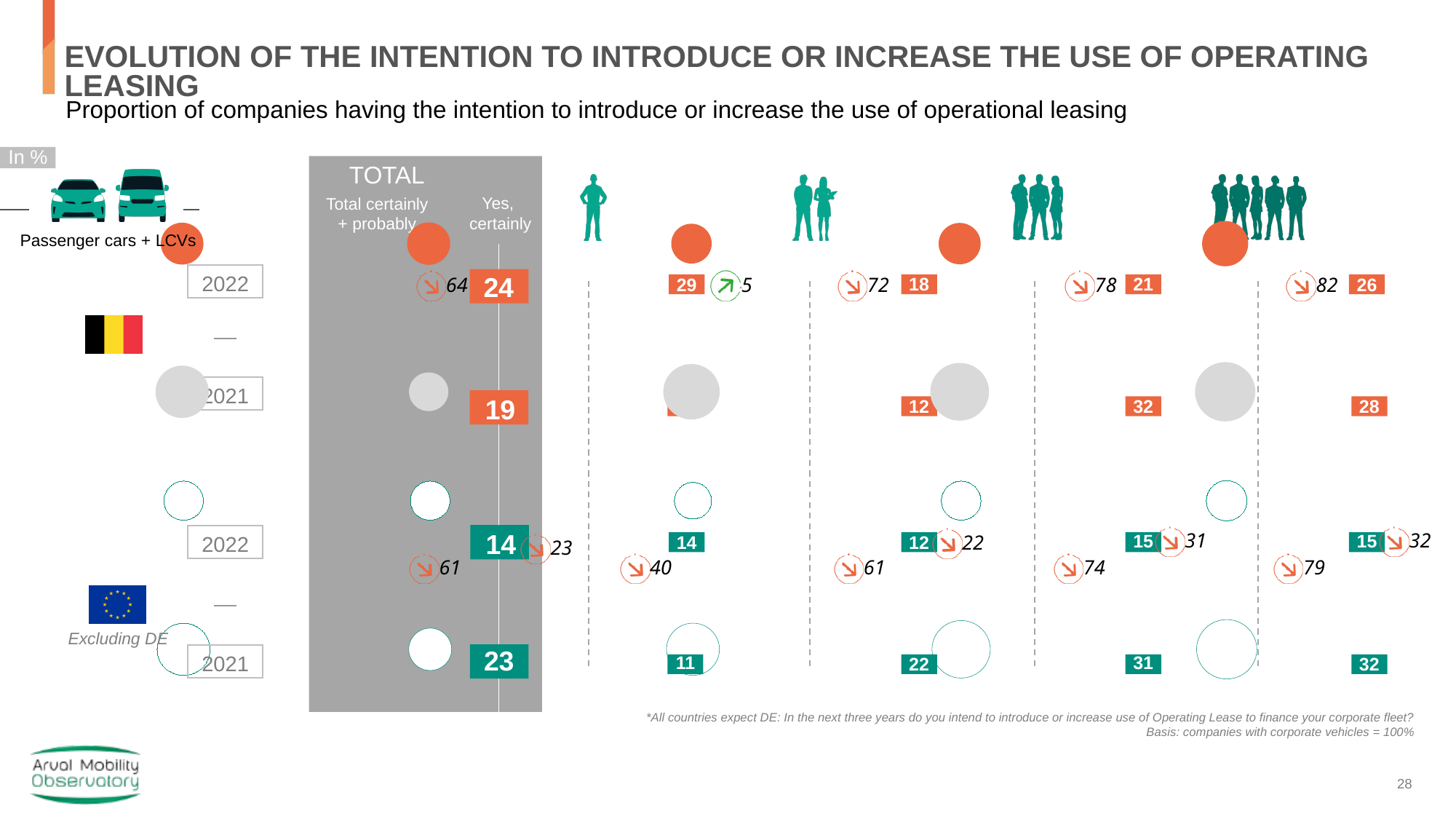
By how much did the TOTAL 'Yes, certainly' value for Belgium change from 2021 to 2022? 5 In the TOTAL column, what is the 'Total certainly + probably' value for Europe (excluding DE) in 2022? 61 In the TOTAL column, what is the 'Yes, certainly' value for Europe (excluding DE) in 2021? 23 What is the difference between the TOTAL 'Yes, certainly' values for Europe (excluding DE) in 2021 and 2022? 9 In the TOTAL column, what is the 'Total certainly + probably' value for Belgium in 2022? 64 In the TOTAL column, what is the 'Yes, certainly' value for Belgium in 2021? 19 For Europe (excluding DE) in 2022, do the 'Total certainly + probably' values rise or fall as company size increases from left to right? Rise For Europe (excluding DE) in 2021, which company-size segment has the lowest 'Yes, certainly' value? The smallest company segment (11) In the TOTAL column, what is the 'Yes, certainly' value for Belgium in 2022? 24 For Europe (excluding DE) in 2022, what is the lowest 'Total certainly + probably' value across the company-size segments? 40 For Belgium in 2022, which company-size segment has the highest 'Total certainly + probably' value? The largest company segment (82) Which has the higher TOTAL 'Total certainly + probably' value in 2022, Belgium or Europe (excluding DE)? Belgium